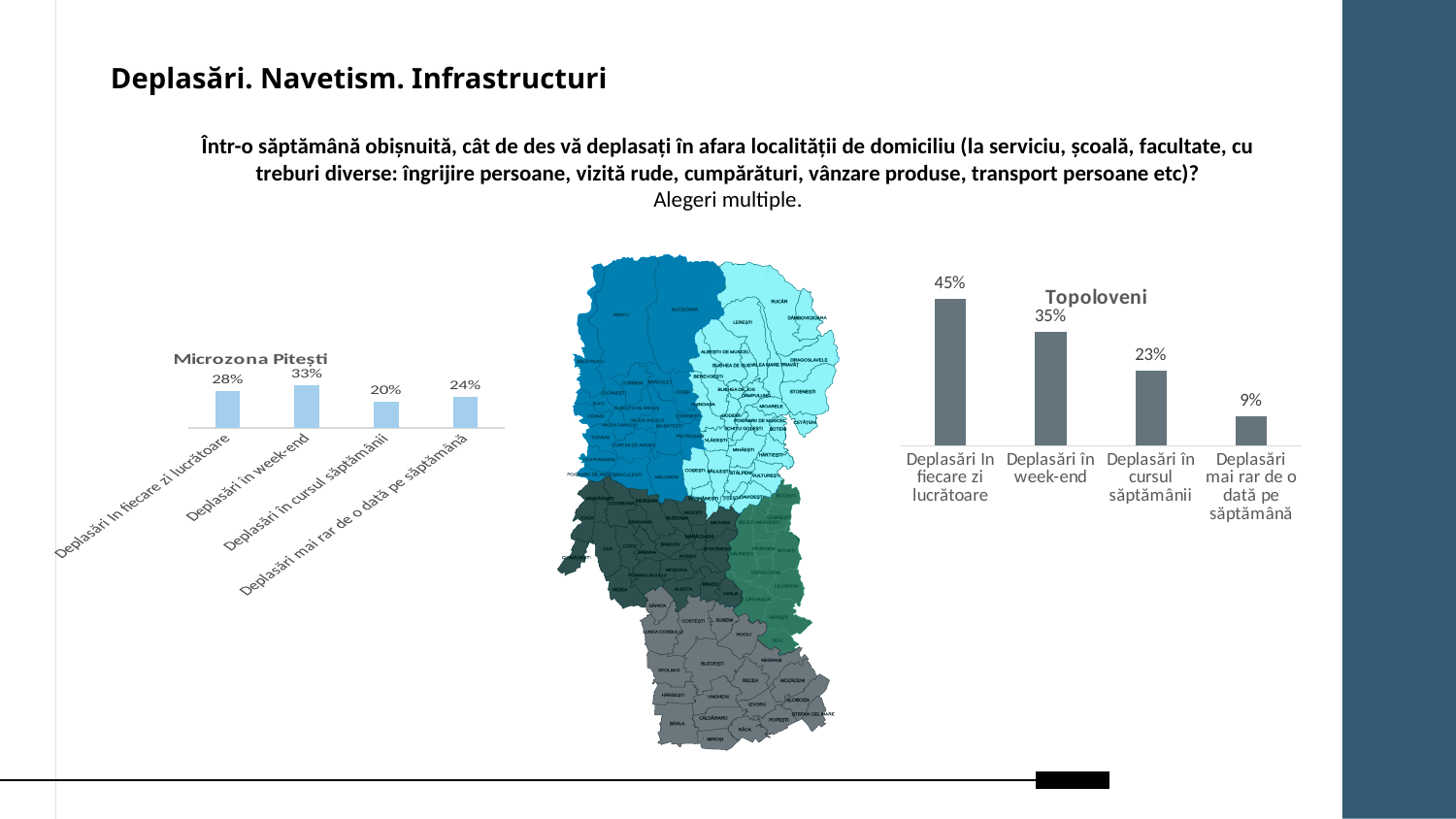
In the Microzona Pitești chart, which category has the highest value? Deplasări în week-end How many categories does the Topoloveni chart show? 4 In the Microzona Pitești chart, what is the value for Deplasări în week-end? 33% In the Topoloveni chart, do the values rise or fall from left to right? Fall In the Topoloveni chart, which category has the lowest value? Deplasări mai rar de o dată pe săptămână In the Topoloveni chart, what is the value for Deplasări mai rar de o dată pe săptămână? 9% In the Microzona Pitești chart, what is the difference between Deplasări mai rar de o dată pe săptămână and Deplasări în cursul săptămânii? 4% What kind of chart is the Microzona Pitești chart? Bar chart In the Topoloveni chart, what is the difference between Deplasări în fiecare zi lucrătoare and Deplasări în week-end? 10% In the Microzona Pitești chart, what is the value for Deplasări în cursul săptămânii? 20% In the Topoloveni chart, what is the value for Deplasări în fiecare zi lucrătoare? 45% In the Topoloveni chart, which is larger: Deplasări în cursul săptămânii or Deplasări mai rar de o dată pe săptămână? Deplasări în cursul săptămânii